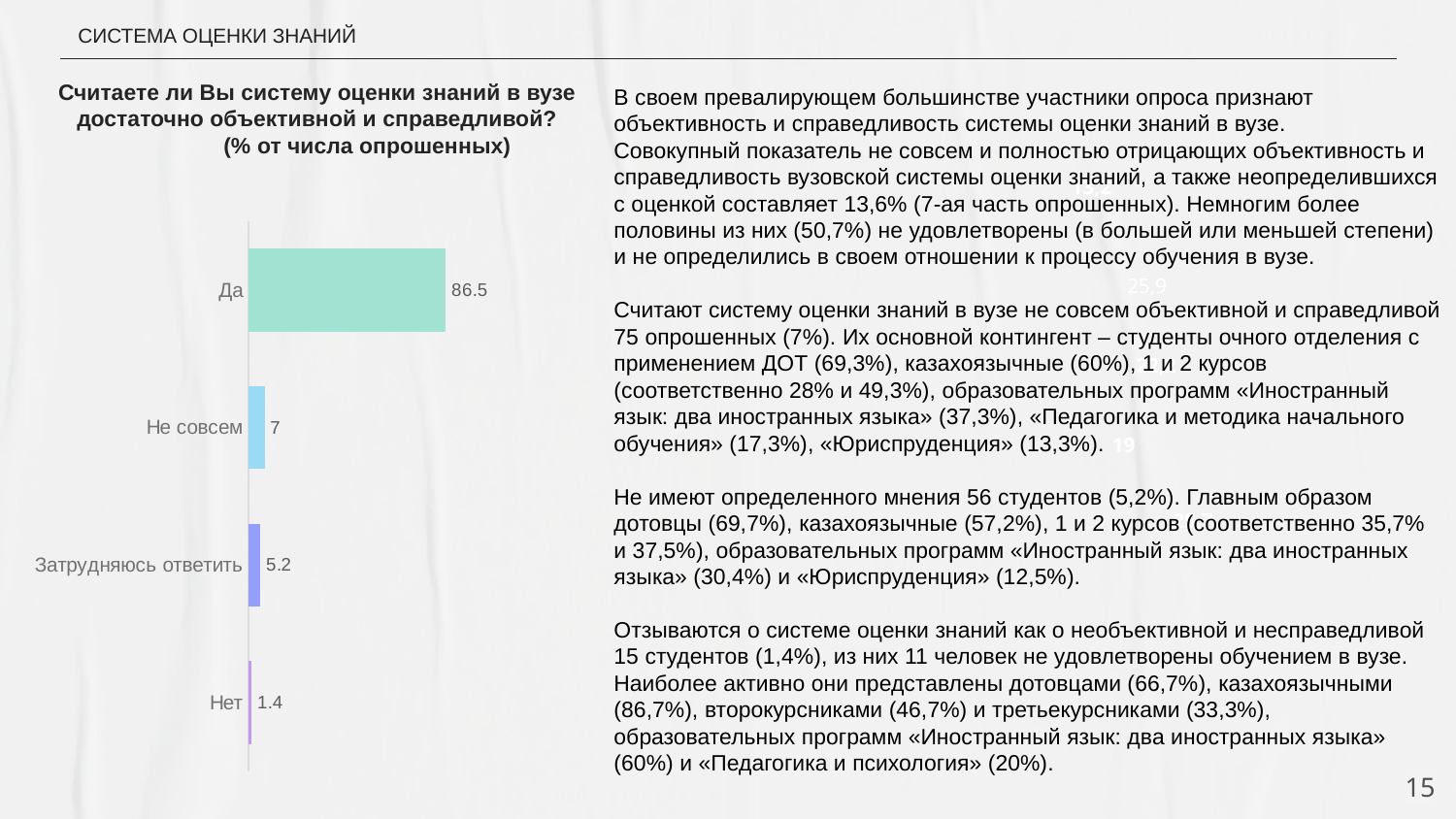
What is the title of the chart? Считаете ли Вы систему оценки знаний в вузе достаточно объективной и справедливой? (% от числа опрошенных) What kind of chart is shown on the slide? Bar chart What is the difference between the values for "Не совсем" and "Затрудняюсь ответить"? 1.8 What is the value for "Нет" in the chart? 1.4 What is the difference between the values for "Да" and "Не совсем"? 79.5 Which category has the lowest value in the chart? Нет Which is larger: the value for "Затрудняюсь ответить" or the value for "Нет"? Затрудняюсь ответить How many categories are shown in the chart? 4 Which category has the highest value in the chart? Да What is the value for "Не совсем" in the chart? 7 What is the value for "Затрудняюсь ответить" in the chart? 5.2 What is the value for "Да" in the chart? 86.5